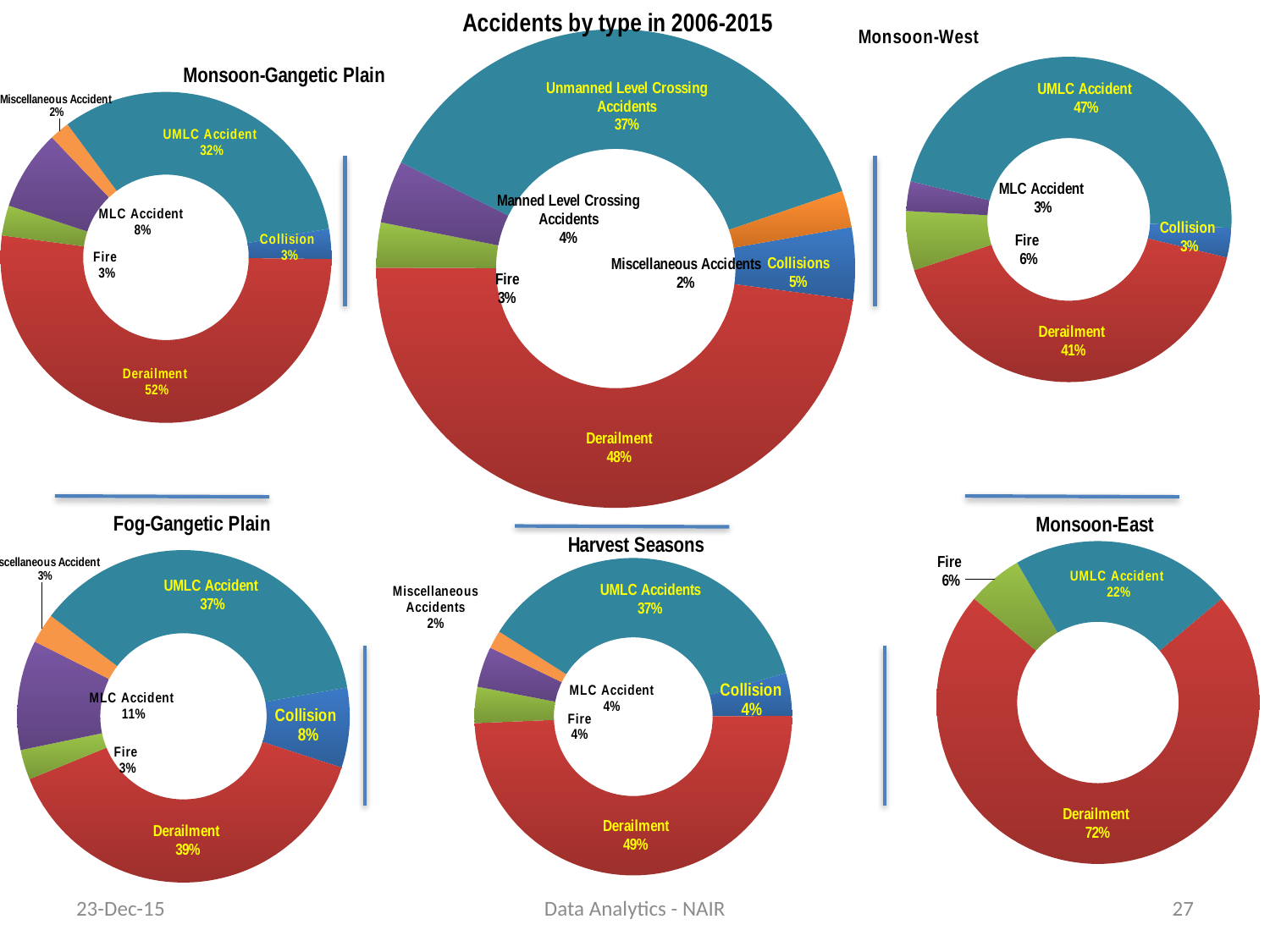
In the 'Harvest Seasons' chart, what share is Derailment? 49% In the 'Monsoon-West' chart, what is the difference between the UMLC Accident share and the Derailment share? 6% In the 'Accidents by type in 2006-2015' chart, what share is Unmanned Level Crossing Accidents? 37% In the 'Accidents by type in 2006-2015' chart, which category has the smallest share? Miscellaneous Accidents In the 'Monsoon-Gangetic Plain' chart, what share is MLC Accident? 8% In the 'Accidents by type in 2006-2015' chart, what share is Derailment? 48% In the 'Fog-Gangetic Plain' chart, which is larger, UMLC Accident or Derailment? Derailment What kind of chart is the 'Monsoon-East' chart? Doughnut (pie) chart In the 'Monsoon-Gangetic Plain' chart, which category has the largest share? Derailment In the 'Fog-Gangetic Plain' chart, what share is Collision? 8% In the 'Monsoon-East' chart, how many slices are there? 3 In the 'Monsoon-West' chart, what share is Fire? 6%